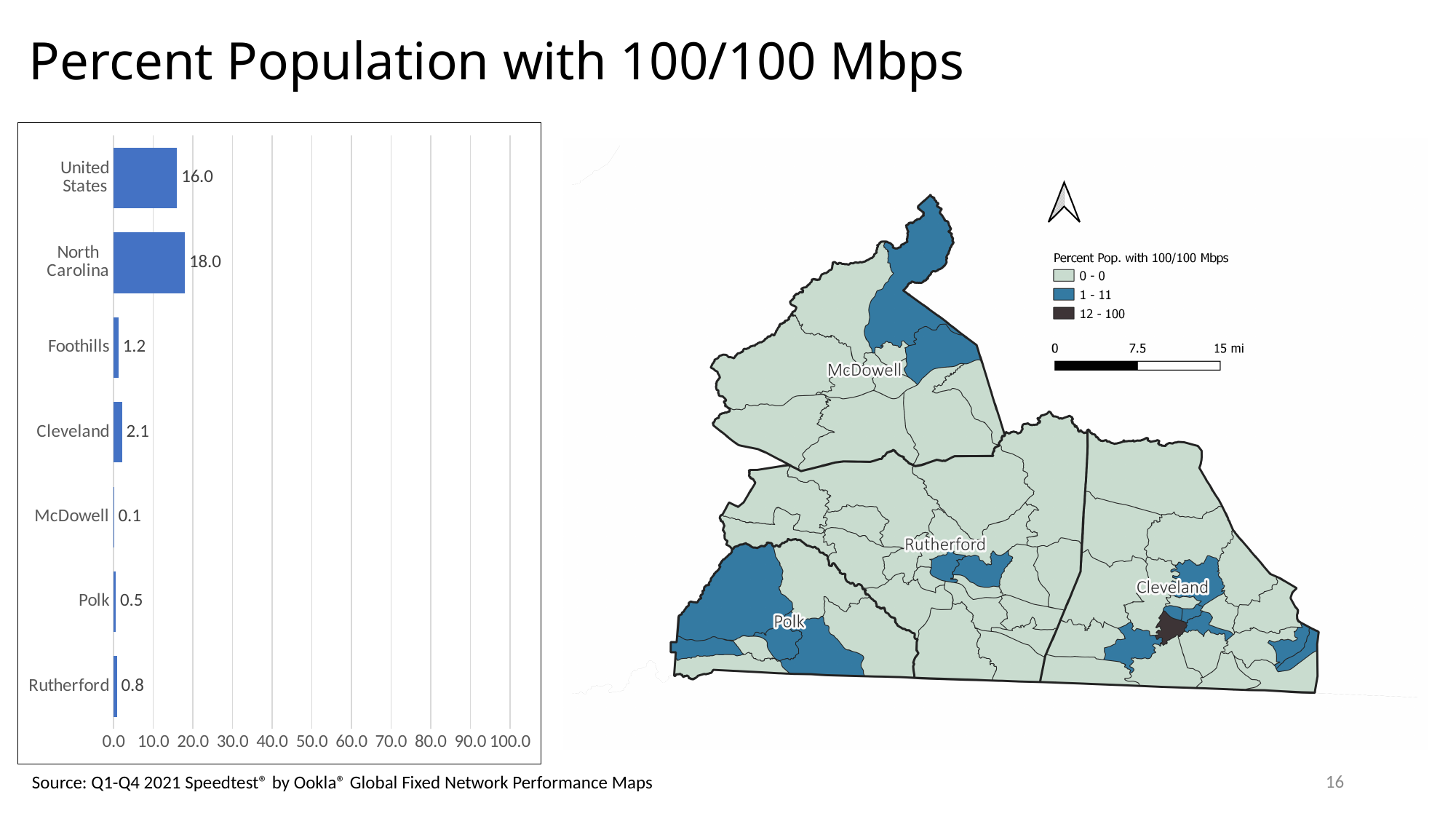
What is the highest value shown on the x axis of the bar chart? 100.0 Which category has the lowest value in the bar chart? McDowell Is the value for the United States greater or less than 10.0? greater What is the value for the United States in the bar chart? 16.0 What is the value for Cleveland in the bar chart? 2.1 What is the value for McDowell in the bar chart? 0.1 Which category has the highest value in the bar chart? North Carolina How many categories are shown in the bar chart? 7 What is the value for North Carolina in the bar chart? 18.0 Which has a larger value, Foothills or Cleveland? Cleveland What kind of chart is shown on the left of the slide? Bar chart What is the difference between the values for North Carolina and the United States? 2.0